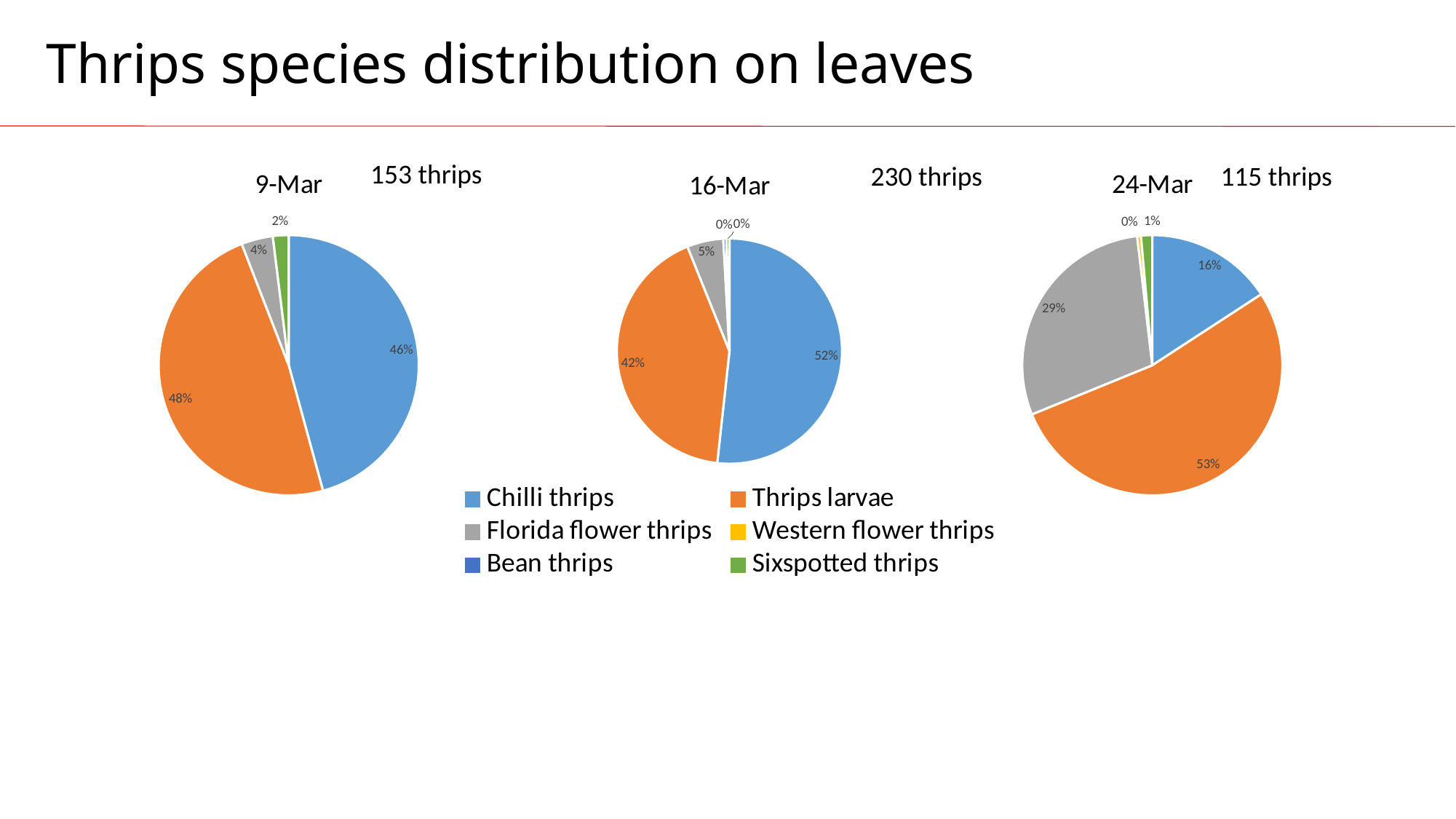
How many species does the legend list? 6 In the 16-Mar chart, which is larger, the Chilli thrips slice or the Thrips larvae slice? Chilli thrips In the 9-Mar chart, what share of thrips are Chilli thrips? 46% In the 24-Mar chart, what share of thrips are Sixspotted thrips? 1% In the 24-Mar chart, which species has the largest slice? Thrips larvae What type of chart is used on this slide? Pie chart In the 16-Mar chart, what share of thrips are Chilli thrips? 52% In the 24-Mar chart, what is the difference between the Thrips larvae share and the Chilli thrips share? 37% How many thrips were counted for the 16-Mar chart? 230 thrips